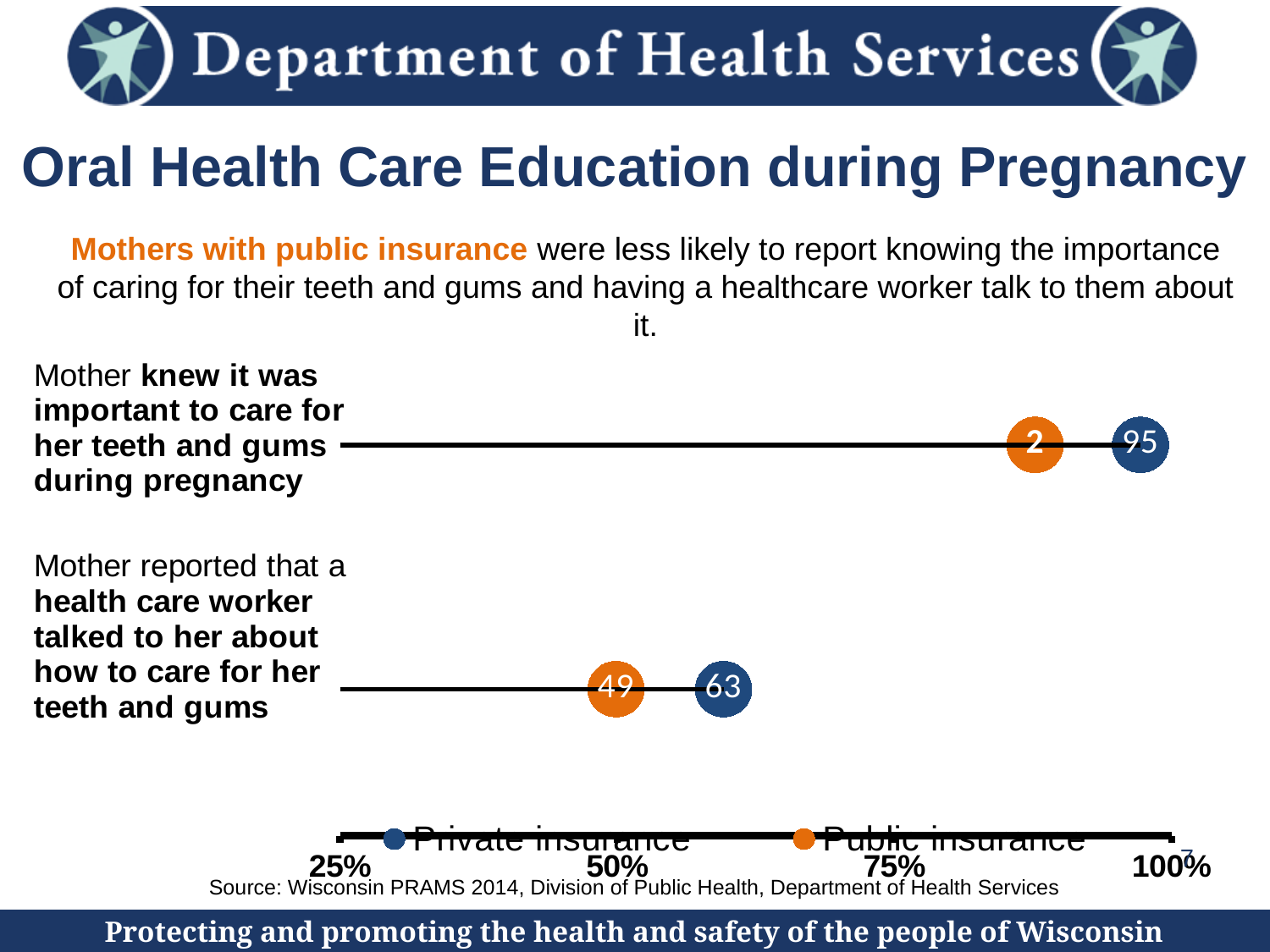
What is the value for Private insurance for 'Mother knew it was important to care for her teeth and gums during pregnancy'? 95 Which colour represents Public insurance in the chart? Orange For 'Mother reported that a health care worker talked to her about how to care for her teeth and gums', what is the difference between the Private insurance and Public insurance values? 14 What kind of chart is shown on the slide? Dot plot For 'Mother reported that a health care worker talked to her about how to care for her teeth and gums', which is larger: Private insurance or Public insurance? Private insurance What is the value for Public insurance for 'Mother reported that a health care worker talked to her about how to care for her teeth and gums'? 49 Is the Public insurance value for 'Mother knew it was important to care for her teeth and gums during pregnancy' greater or less than 75%? greater What is the value for Private insurance for 'Mother reported that a health care worker talked to her about how to care for her teeth and gums'? 63 How many categories (statements) are plotted in the chart? 2 How many series does the chart legend list? 2 Is the Public insurance value for 'Mother reported that a health care worker talked to her about how to care for her teeth and gums' greater or less than 50%? less For 'Mother knew it was important to care for her teeth and gums during pregnancy', which is larger: Private insurance or Public insurance? Private insurance